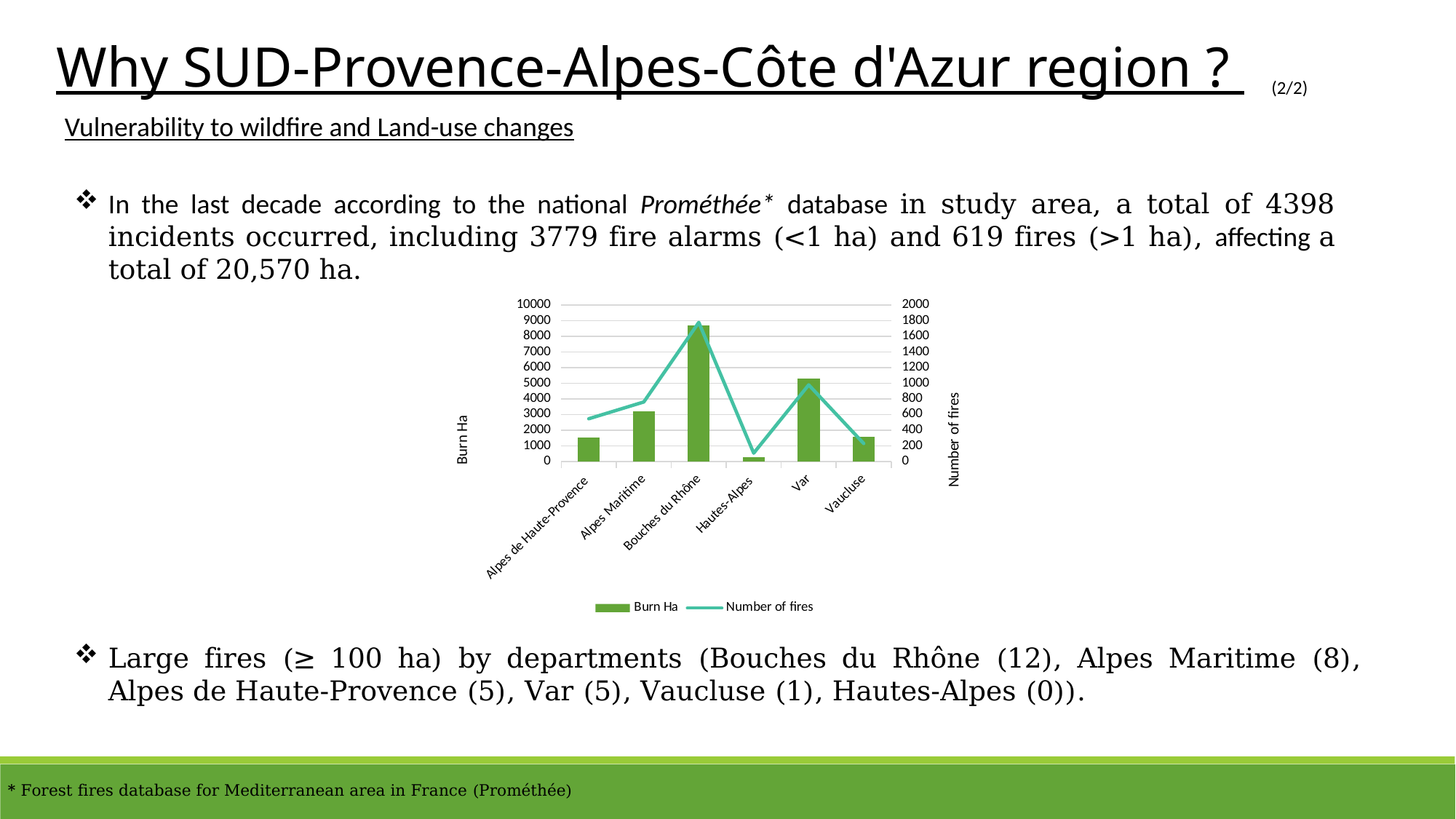
Is the Burn Ha value for Bouches du Rhône greater or less than 8000? greater Which department has the lowest Burn Ha value in the chart? Hautes-Alpes Which department has the lowest Number of fires in the chart? Hautes-Alpes Is the Number of fires for Bouches du Rhône greater or less than 1600? greater Which department has the highest Number of fires in the chart? Bouches du Rhône How many departments are shown on the x axis of the chart? 6 Is the Number of fires for Vaucluse greater or less than 400? less What is the label of the right-hand vertical axis of the chart? Number of fires How many series does the chart legend list? 2 Which department has the highest Burn Ha value in the chart? Bouches du Rhône Which has the larger Burn Ha value, Var or Alpes Maritime? Var